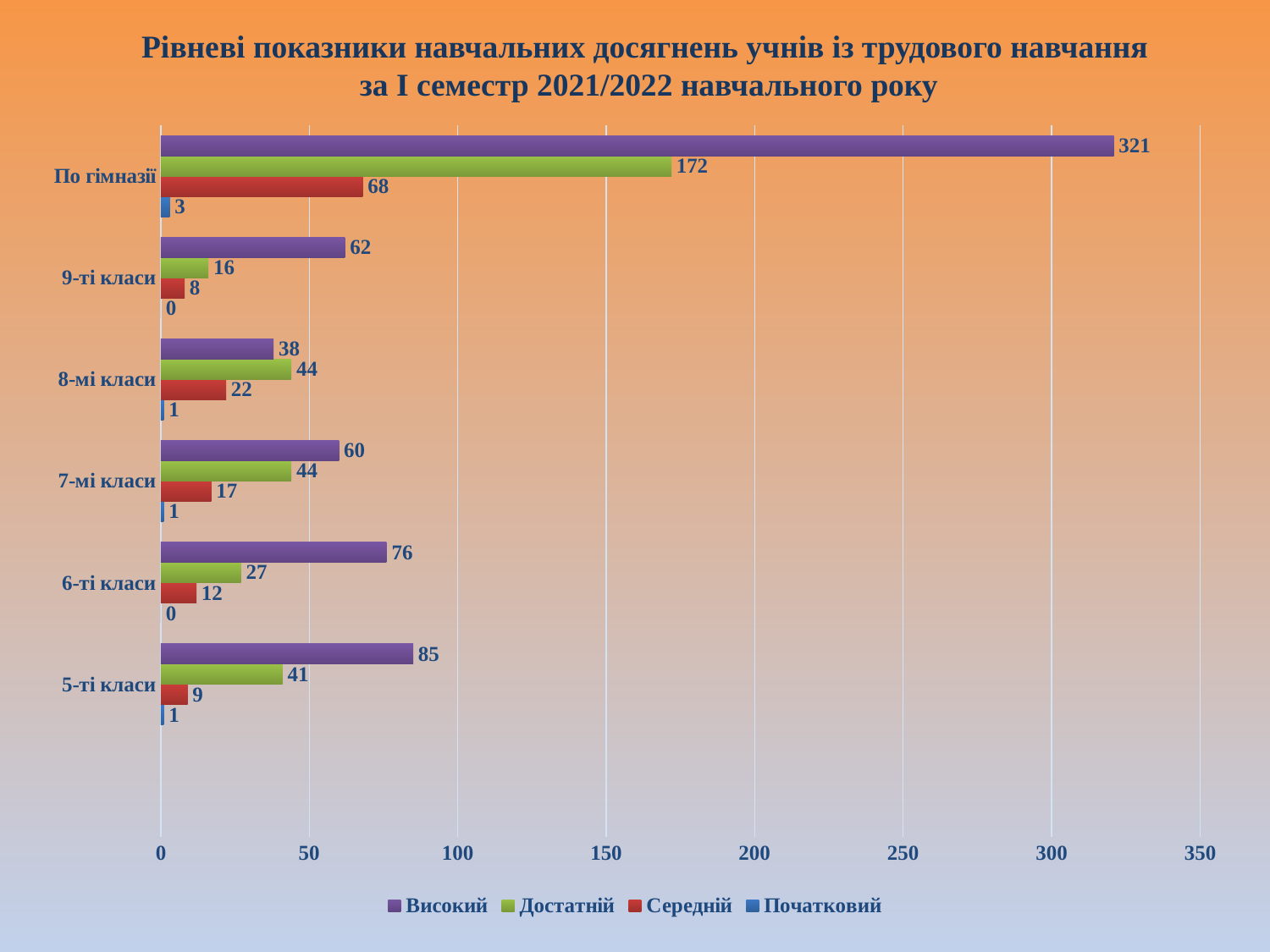
Which is larger for 8-мі класи: Високий or Достатній? Достатній What is the value for Високий for По гімназії? 321 What is the value for Початковий for 9-ті класи? 0 Among the class categories (excluding По гімназії), which has the lowest Достатній value? 9-ті класи Among the class categories (excluding По гімназії), which has the highest Високий value? 5-ті класи How many series does the legend list? 4 What kind of chart is shown on the slide? Bar chart What is the value for Середній for 6-ті класи? 12 How many categories are shown on the y axis? 6 What is the value for Достатній for 8-мі класи? 44 What is the total of the four values for 7-мі класи? 122 What is the difference between the Високий values for 5-ті класи and 6-ті класи? 9